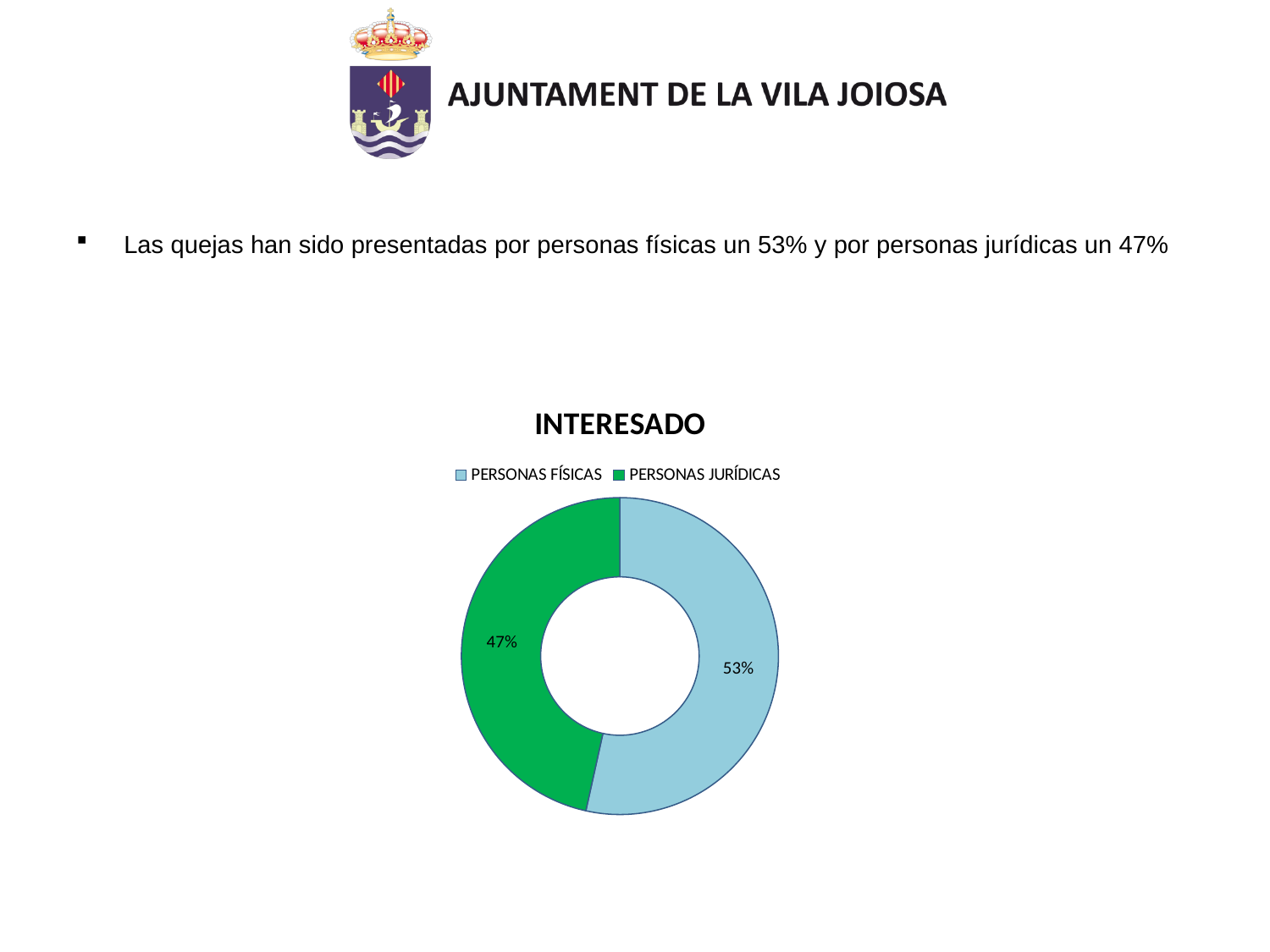
Which category has the largest share in the chart? PERSONAS FÍSICAS What is the total of the two shares shown in the chart? 100% What colour is the PERSONAS JURÍDICAS slice? Green What share of the chart does PERSONAS JURÍDICAS represent? 47% How many categories does the chart show? 2 What share of the chart does PERSONAS FÍSICAS represent? 53% Which category has the smallest share in the chart? PERSONAS JURÍDICAS How many entries does the legend list? 2 What is the difference in percentage points between PERSONAS FÍSICAS and PERSONAS JURÍDICAS? 6 percentage points What is the title of the chart? INTERESADO Which is larger, the share for PERSONAS FÍSICAS or for PERSONAS JURÍDICAS? PERSONAS FÍSICAS What kind of chart is shown on the slide? Doughnut chart